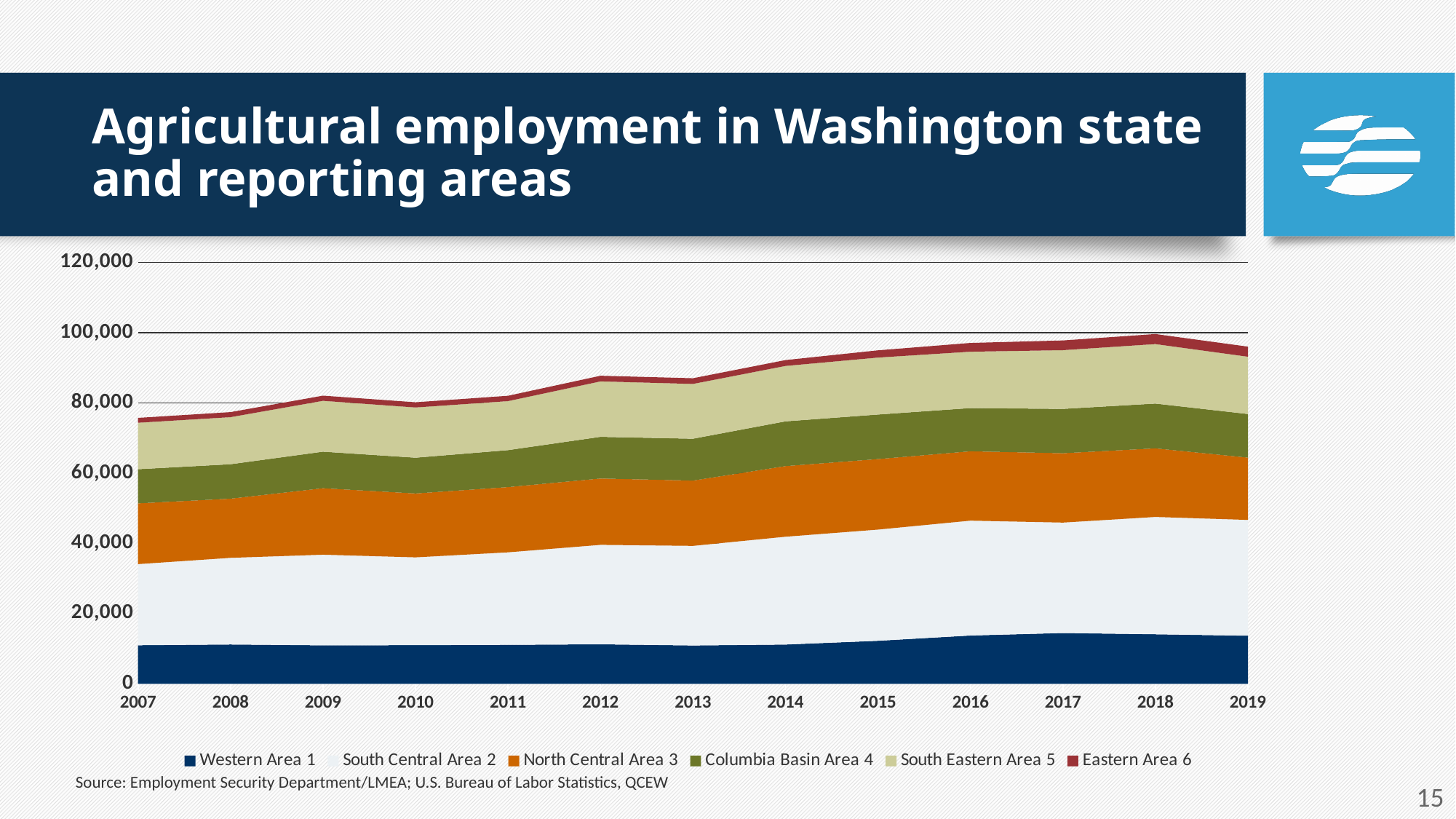
Is the value for Western Area 1 in 2007 greater or less than 20,000? less What is the first year shown on the x axis? 2007 How many years are shown along the x axis? 13 Is the total agricultural employment in 2007 greater or less than 80,000? less Which is larger, total agricultural employment in 2019 or in 2007? 2019 What is the last year shown on the x axis? 2019 What kind of chart is shown on the slide? Stacked area chart How many series does the legend list? 6 Is the total agricultural employment in 2013 greater or less than 80,000? greater In which year is total agricultural employment lowest? 2007 Does total agricultural employment generally rise or fall from 2007 to 2019? rise